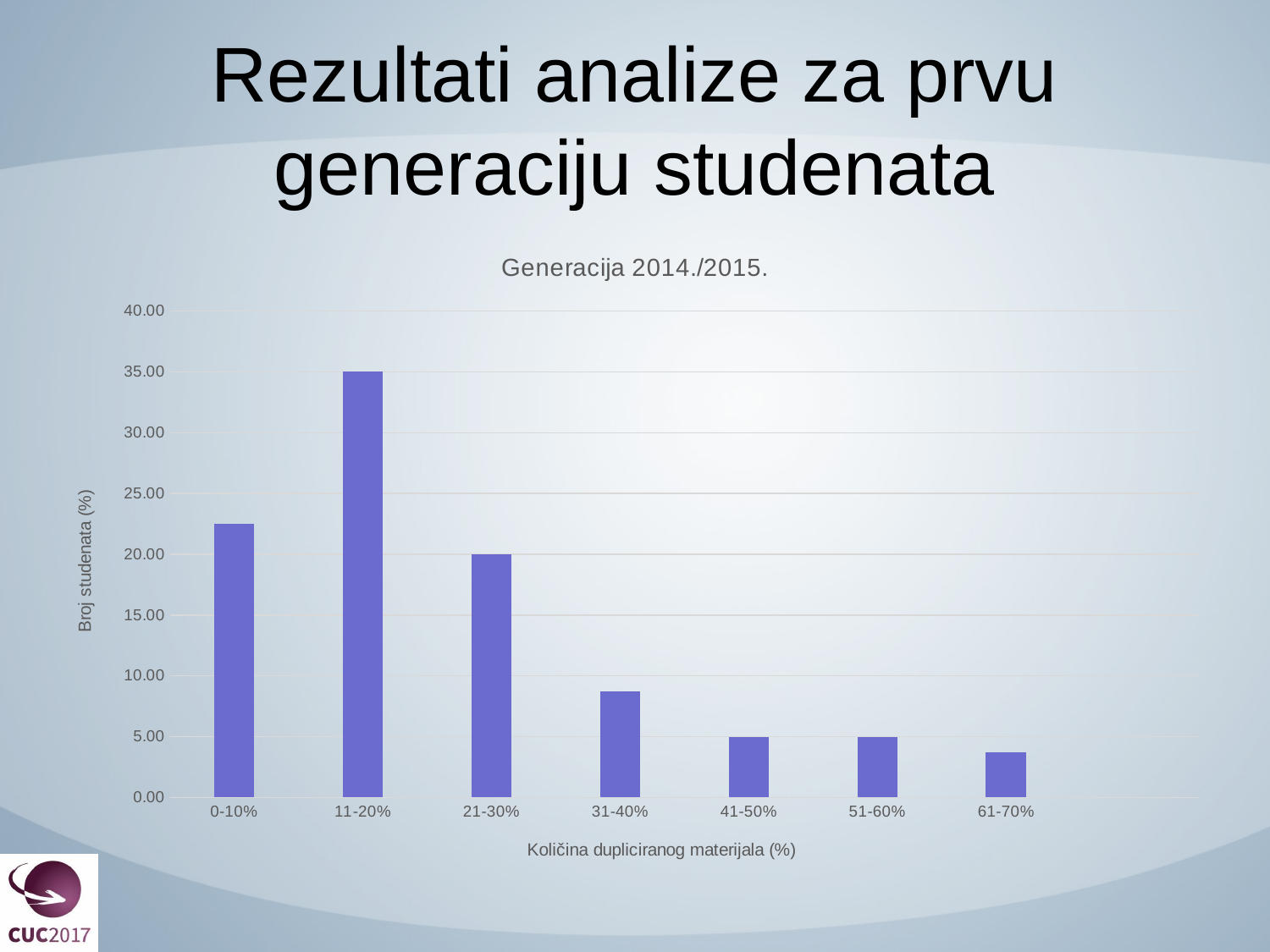
What is the label of the x axis of the chart? Količina dupliciranog materijala (%) Is the value for 61-70% greater or less than 5.00? less Is the value for 0-10% greater or less than 20.00? greater Which category has the highest value in the chart? 11-20% What is the title of the chart? Generacija 2014./2015. Which is larger, the value for 0-10% or the value for 21-30%? 0-10% What is the value for the 21-30% category? 20.00 Is the value for 31-40% greater or less than 10.00? less What is the value for the 11-20% category? 35.00 What kind of chart is shown on the slide? Bar chart How many categories are shown on the x axis of the chart? 7 Which category has the lowest value in the chart? 61-70%